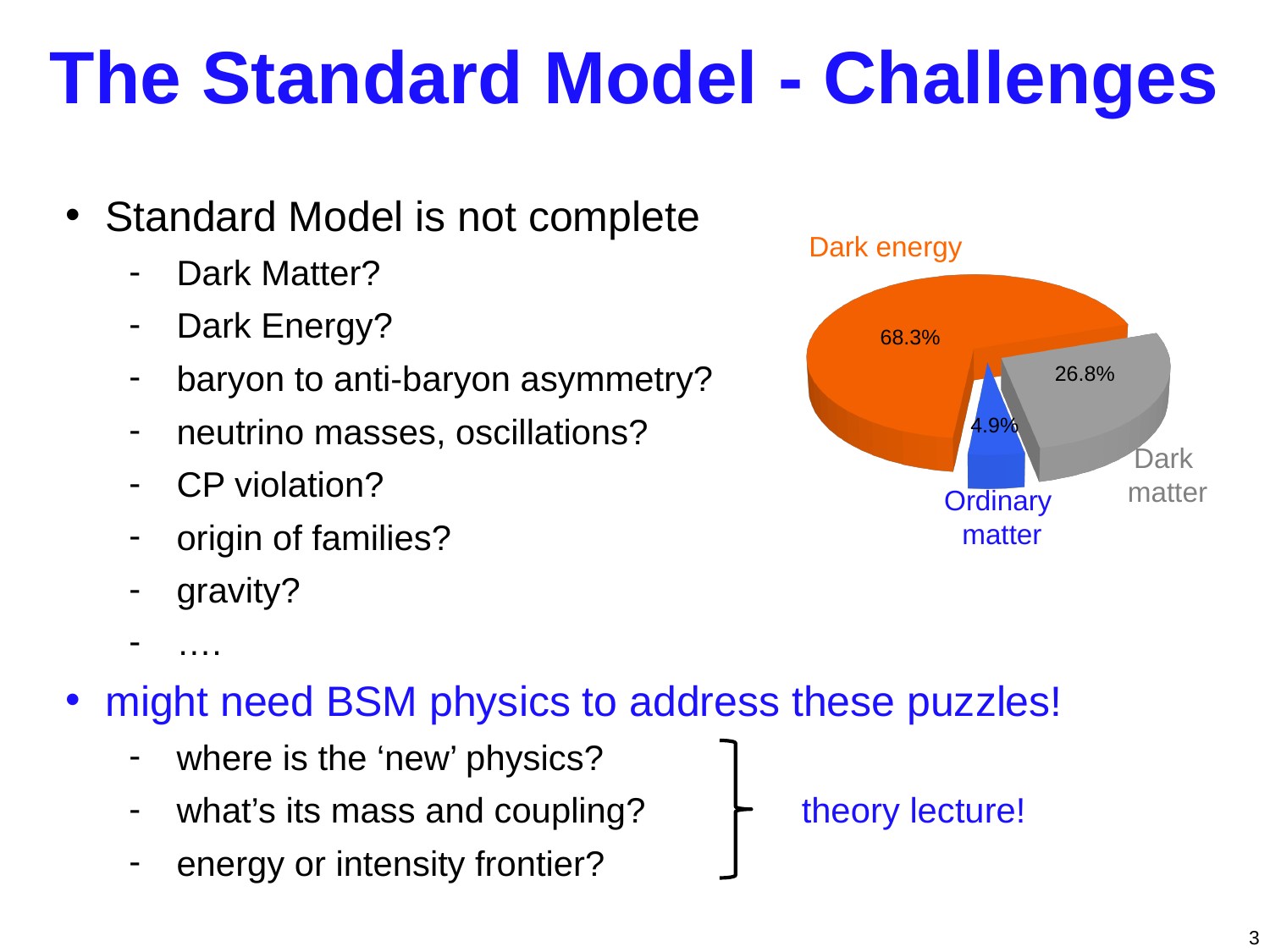
Which slice of the pie is the largest? Dark energy What is the difference in percentage points between the Dark matter slice and the Ordinary matter slice? 21.9 What colour is the Ordinary matter slice? blue Which slice of the pie is the smallest? Ordinary matter How many slices does the pie chart have? 3 What kind of chart is shown on the slide? pie chart What share of the pie does Ordinary matter have? 4.9% What share of the pie does Dark matter have? 26.8% Which is larger, the Dark matter slice or the Ordinary matter slice? Dark matter What share of the pie does Dark energy have? 68.3% What colour is the Dark energy slice? orange What is the difference in percentage points between the Dark energy slice and the Dark matter slice? 41.5